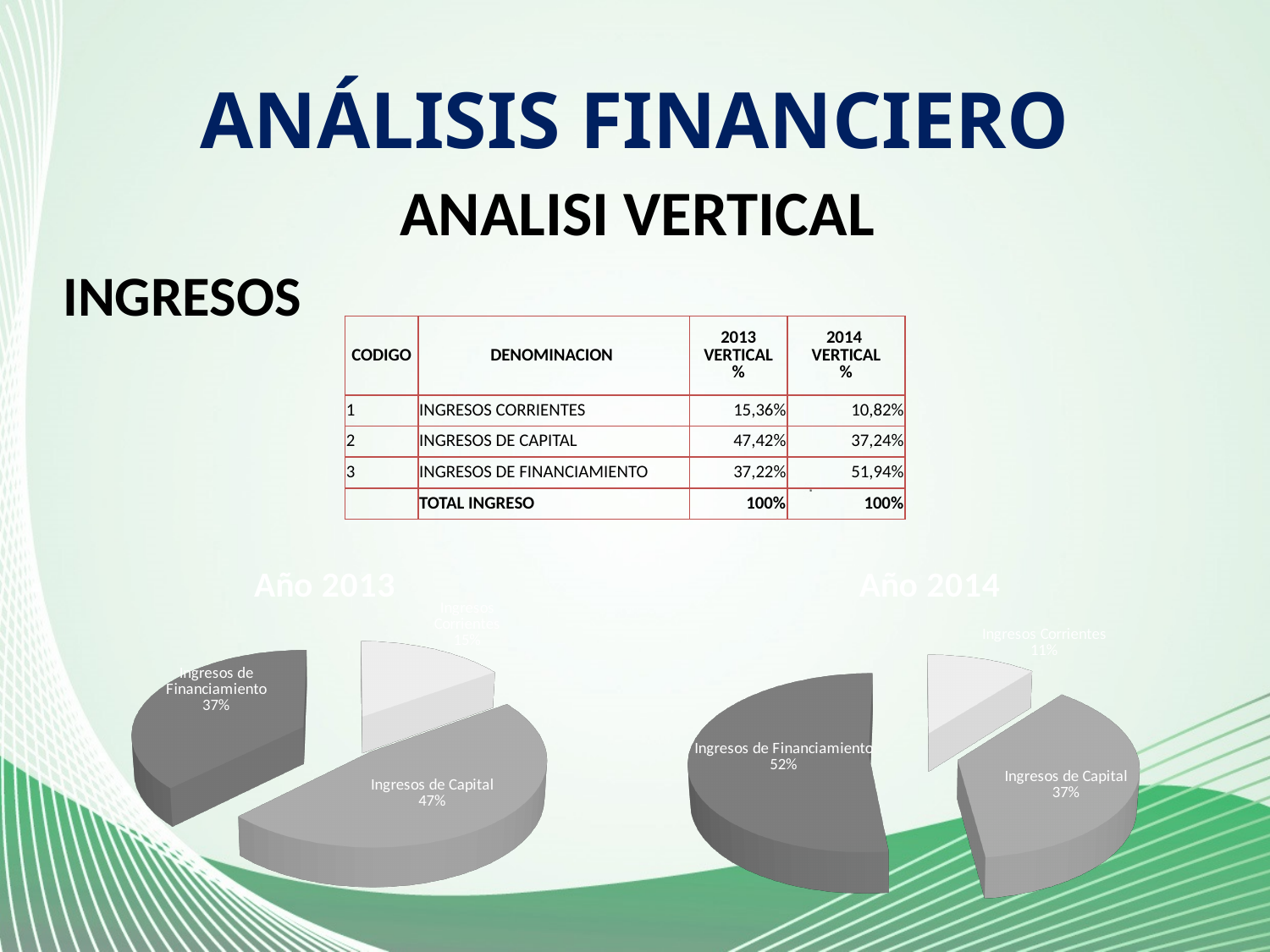
In the "Año 2013" chart, what share does Ingresos de Financiamiento have? 37% In the "Año 2014" chart, what share does Ingresos de Financiamiento have? 52% In the "Año 2014" chart, which slice is the smallest? Ingresos Corrientes What kind of chart is the "Año 2013" chart? Pie chart How many slices does the "Año 2014" pie chart have? 3 In the "Año 2014" chart, which slice is the largest? Ingresos de Financiamiento In the "Año 2014" chart, what share does Ingresos de Capital have? 37% In the "Año 2013" chart, what is the difference between the Ingresos de Capital share and the Ingresos de Financiamiento share? 10% In the "Año 2013" chart, which slice is the largest? Ingresos de Capital What is the title of the pie chart on the right side of the slide? Año 2014 In the "Año 2013" chart, which is larger, Ingresos de Capital or Ingresos de Financiamiento? Ingresos de Capital